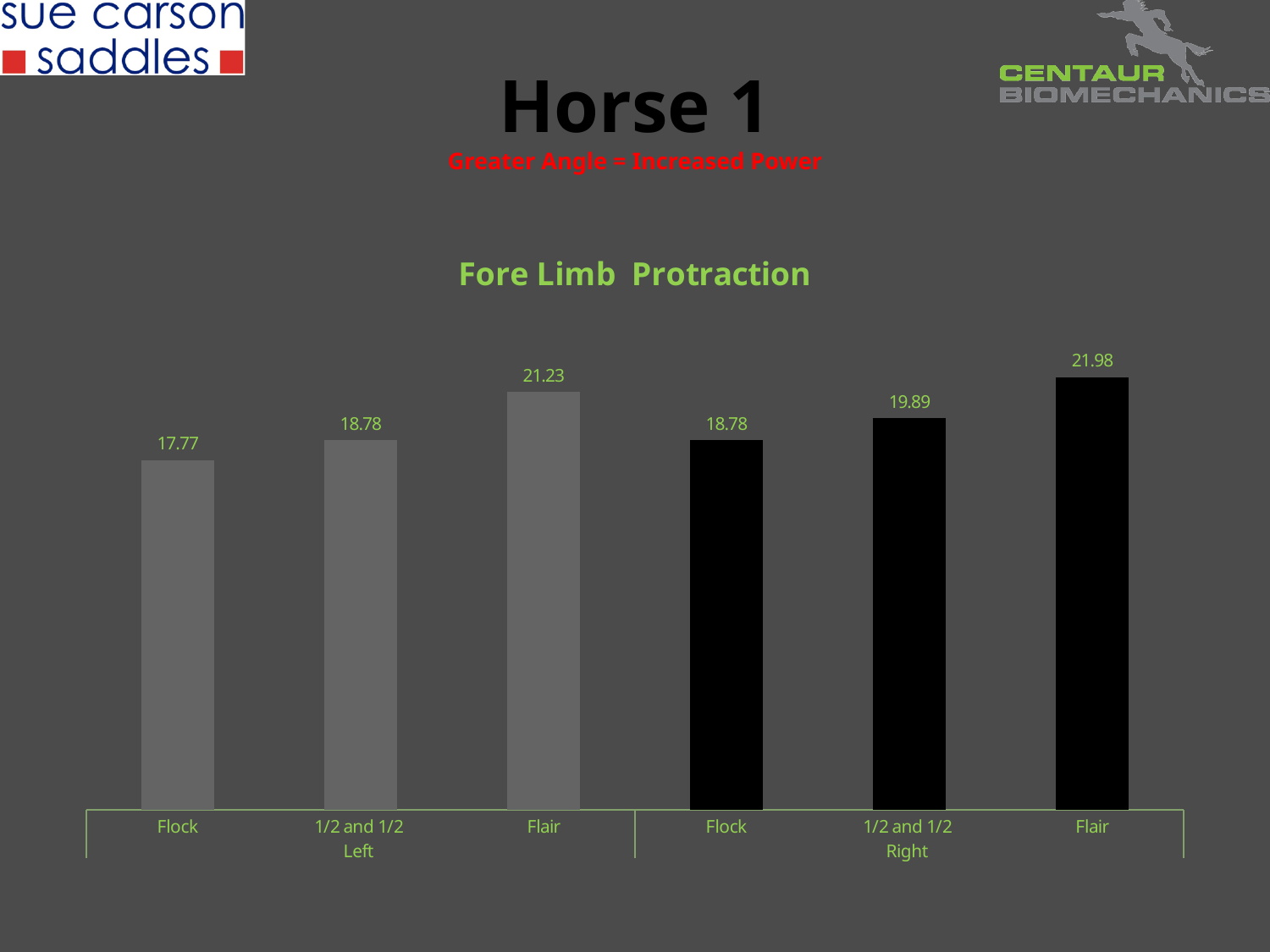
What is the difference between the Flair and Flock values under Left in the Fore Limb Protraction chart? 3.46 What is the value for Flair under Right in the Fore Limb Protraction chart? 21.98 Which bar has the lowest value in the Fore Limb Protraction chart? Flock (Left) Which bar has the highest value in the Fore Limb Protraction chart? Flair (Right) What is the value for 1/2 and 1/2 under Right in the Fore Limb Protraction chart? 19.89 Within the Left group of the Fore Limb Protraction chart, do the values rise or fall from Flock to Flair? Rise What kind of chart is the Fore Limb Protraction chart? Bar chart What is the value for Flock under Left in the Fore Limb Protraction chart? 17.77 What is the difference between the Flair values for Right and Left in the Fore Limb Protraction chart? 0.75 Which is larger in the Fore Limb Protraction chart: 1/2 and 1/2 under Left or 1/2 and 1/2 under Right? 1/2 and 1/2 under Right What is the title of the chart on the slide? Fore Limb Protraction How many bars are plotted in the Fore Limb Protraction chart? 6